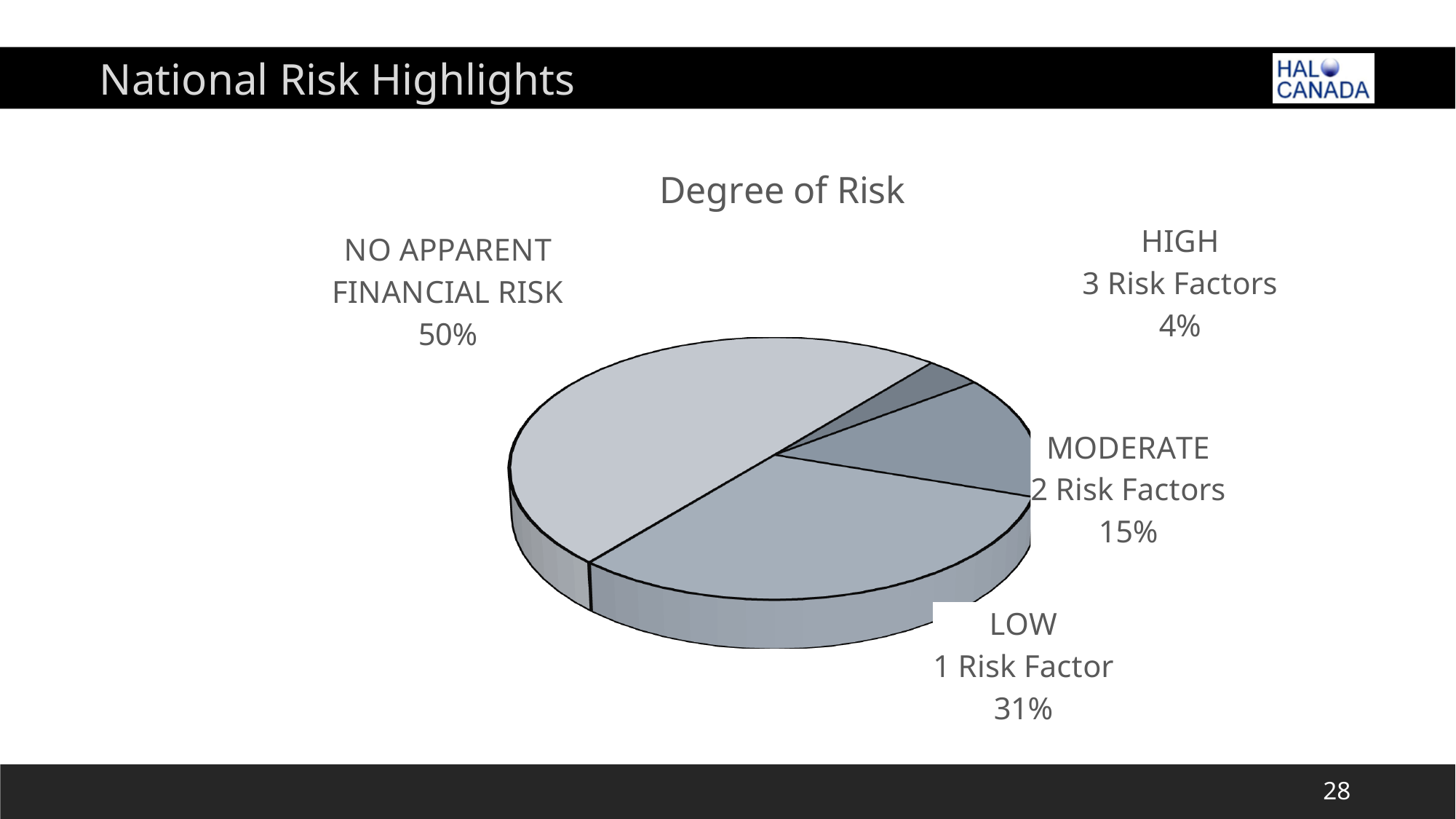
Which is larger, the MODERATE slice or the HIGH slice? MODERATE What type of chart is shown on the slide? pie chart What is the title of the chart? Degree of Risk What share of the pie is MODERATE (2 Risk Factors)? 15% How many slices does the pie chart have? 4 How many risk factors are associated with the MODERATE category? 2 Risk Factors What share of the pie is HIGH (3 Risk Factors)? 4% Which category has the smallest share of the pie? HIGH (3 Risk Factors) What is the difference in percentage points between the LOW and MODERATE slices? 16 Which category has the largest share of the pie? NO APPARENT FINANCIAL RISK What share of the pie is LOW (1 Risk Factor)? 31%